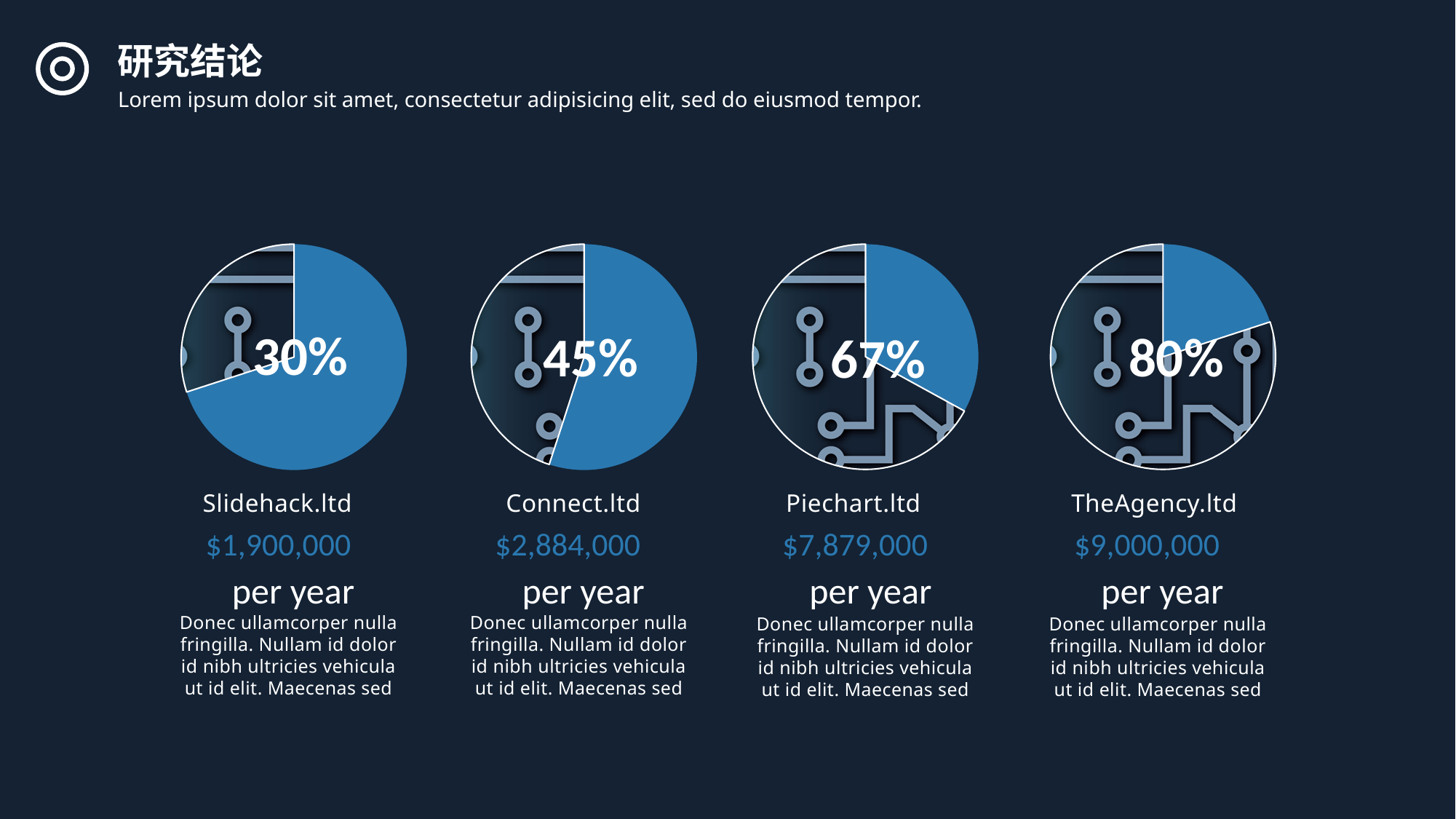
Which has the larger percentage, the Connect.ltd chart or the Piechart.ltd chart? Piechart.ltd What is the difference between the percentages shown on the TheAgency.ltd and Slidehack.ltd pie charts? 50% What percentage is shown on the TheAgency.ltd pie chart? 80% What percentage is shown on the Connect.ltd pie chart? 45% Which of the four pie charts shows the lowest percentage? Slidehack.ltd How many pie charts are on the slide? 4 What percentage is shown on the Piechart.ltd pie chart? 67% What percentage is shown on the Slidehack.ltd pie chart? 30% What yearly amount is listed under the Connect.ltd chart? $2,884,000 What kind of chart is used for each of the four companies on the slide? Pie chart Which of the four pie charts shows the highest percentage? TheAgency.ltd What yearly amount is listed under the Piechart.ltd chart? $7,879,000